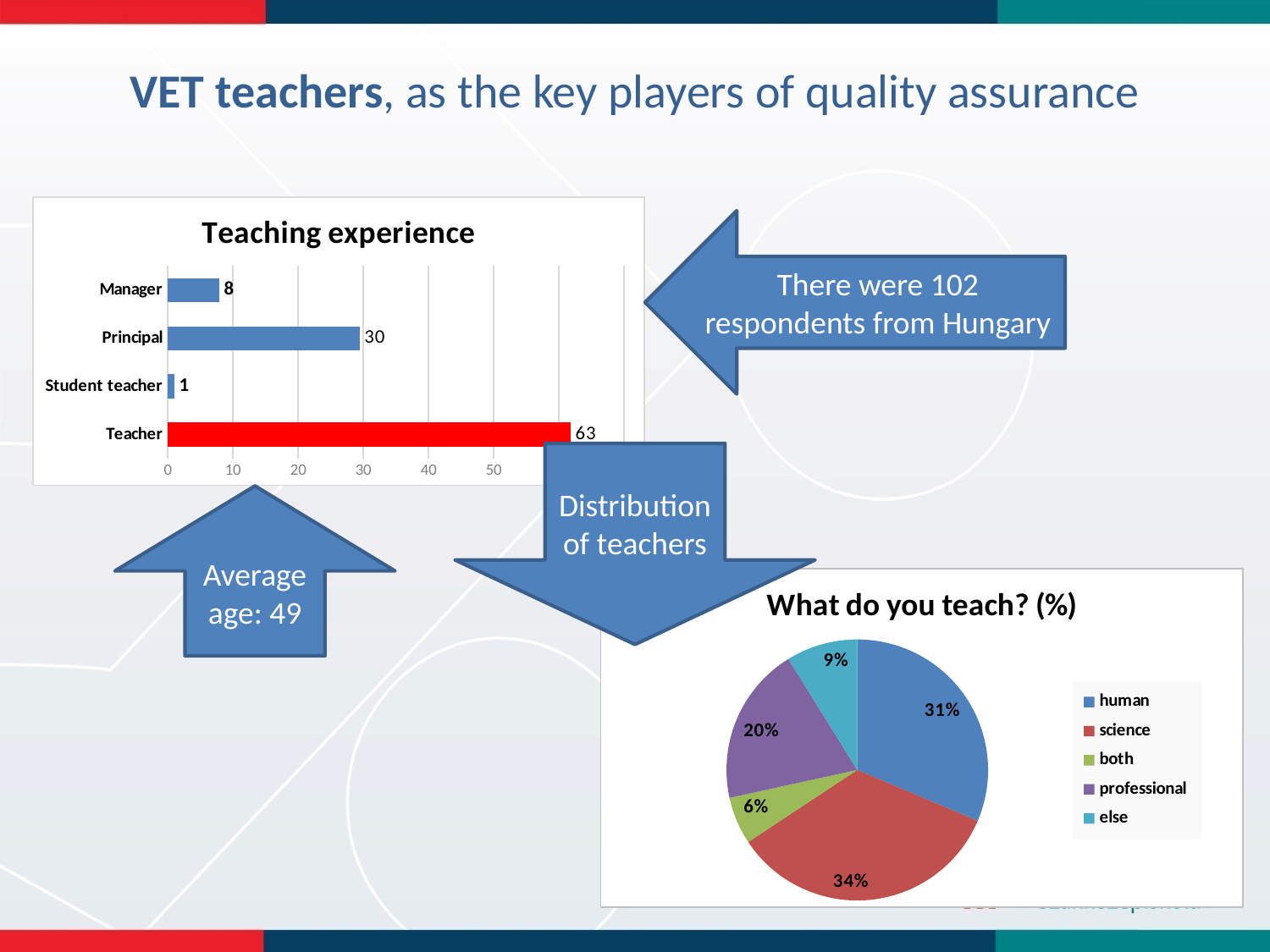
In the 'What do you teach? (%)' chart, what share is labelled for science? 34% In the 'Teaching experience' chart, what is the value for Teacher? 63 What kind of chart is the 'Teaching experience' chart? Bar chart In the 'What do you teach? (%)' chart, what share is labelled for professional? 20% In the 'Teaching experience' chart, which category has the highest value? Teacher In the 'What do you teach? (%)' chart, is the slice for human larger or smaller than the slice for science? smaller In the 'Teaching experience' chart, which category has the lowest value? Student teacher In the 'Teaching experience' chart, what is the difference between the values for Teacher and Principal? 33 In the 'What do you teach? (%)' chart, how many entries does the legend list? 5 In the 'Teaching experience' chart, what is the value for Principal? 30 In the 'Teaching experience' chart, how many categories are shown? 4 In the 'What do you teach? (%)' chart, which category has the smallest slice? both